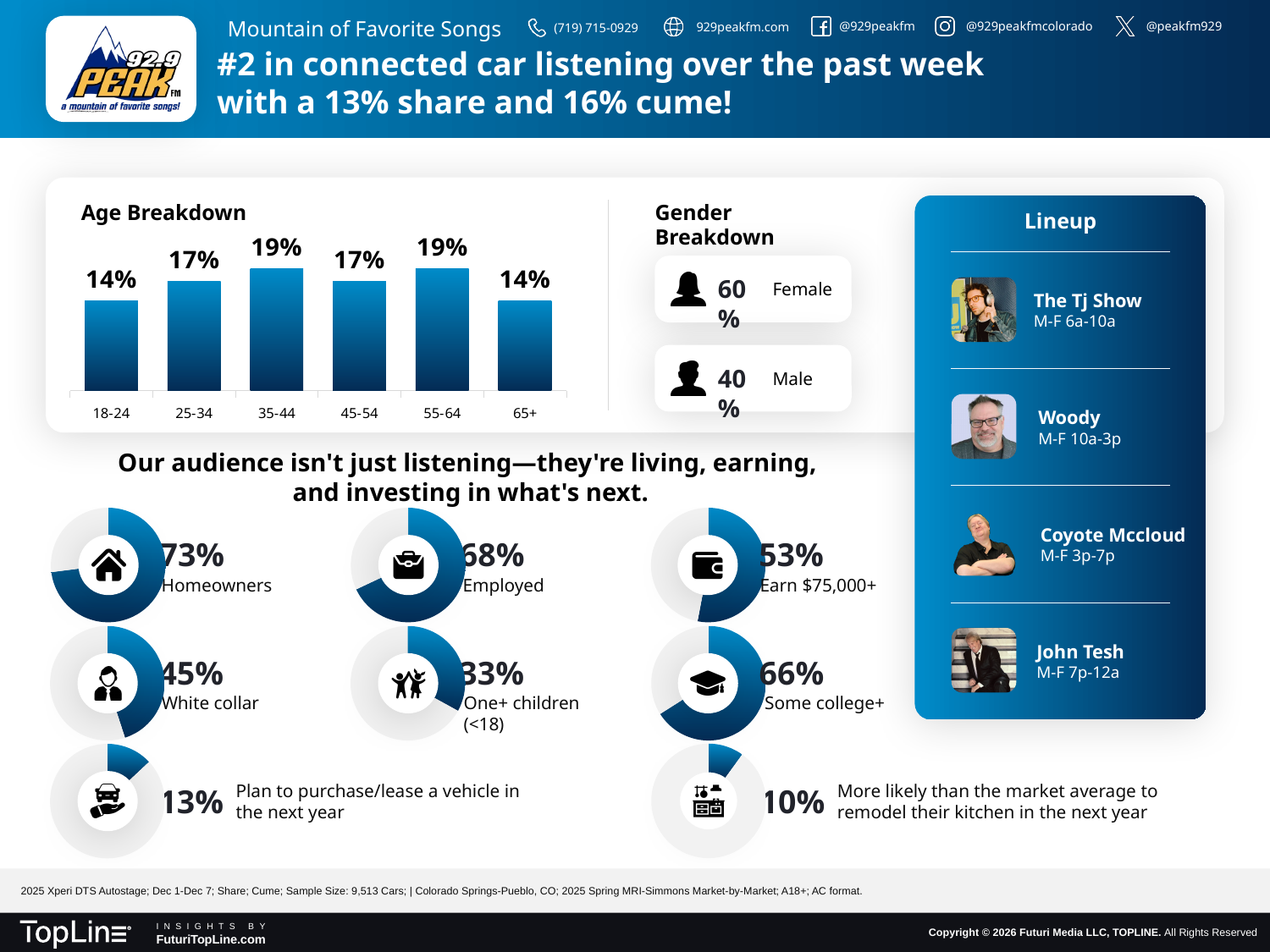
In the Age Breakdown chart, what is the difference between the 35-44 and 18-24 values? 5% What kind of chart is the Age Breakdown chart? Bar chart In the donut charts, which is larger, the share that is Employed or the share with Some college+? Employed In the Age Breakdown chart, what is the value for the 25-34 age group? 17% In the donut charts, what percentage of the audience has One+ children (<18)? 33% In the Age Breakdown chart, what is the value for the 35-44 age group? 19% In the Age Breakdown chart, which is larger, the value for 45-54 or the value for 65+? 45-54 In the Gender Breakdown chart, what is the difference between the Female and Male shares? 20% How many age groups are shown in the Age Breakdown chart? 6 In the donut charts, what percentage of the audience are Homeowners? 73% In the Age Breakdown chart, what is the value for the 65+ age group? 14% In the Gender Breakdown chart, what percentage of the audience is Female? 60%